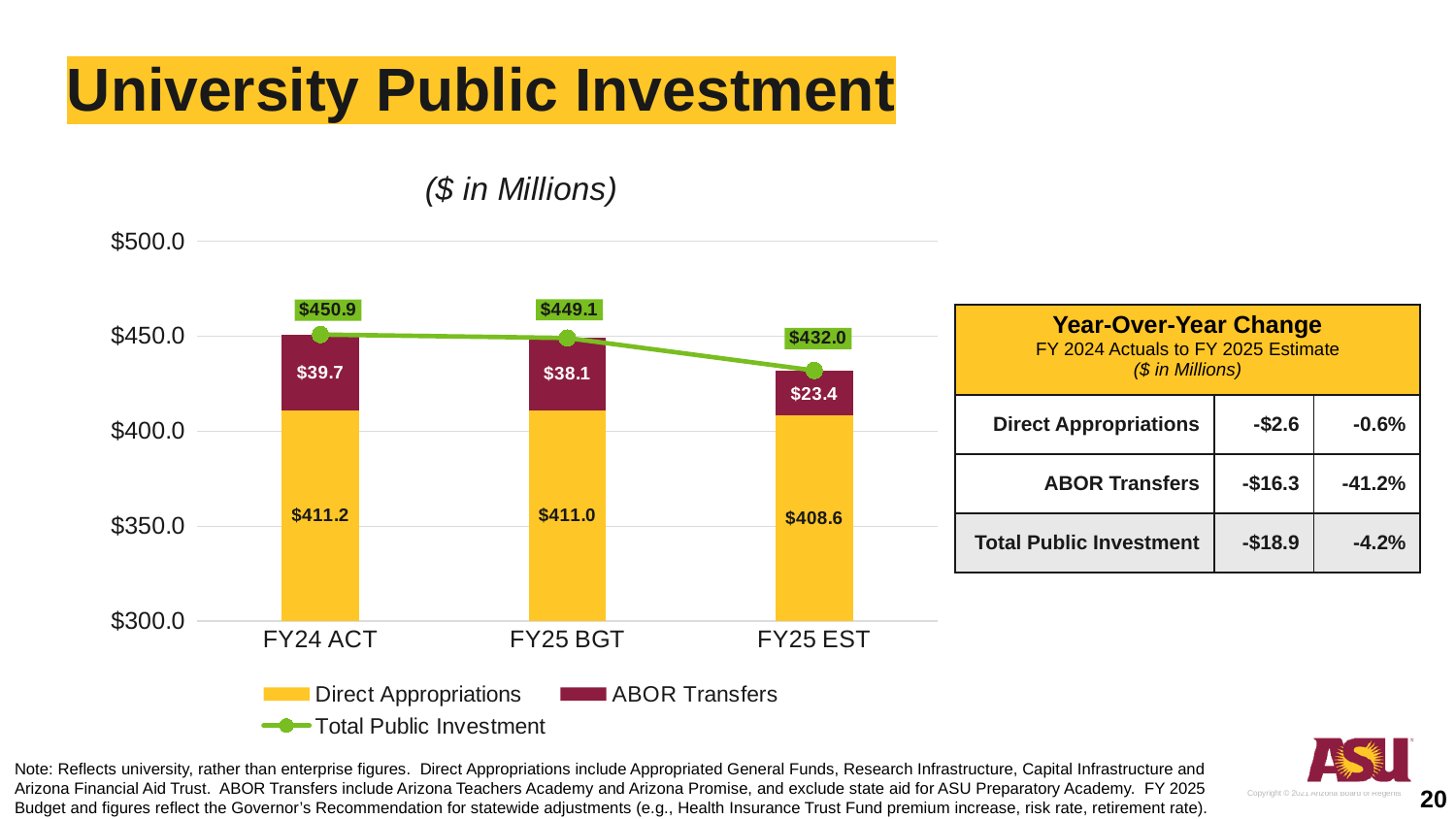
Which is larger, Direct Appropriations for FY24 ACT or for FY25 EST? FY24 ACT How many categories are shown on the x axis? 3 Is the Total Public Investment for FY25 EST greater or less than $450.0? less What is the value of ABOR Transfers for FY25 EST? $23.4 Which category has the highest ABOR Transfers value? FY24 ACT What is the Total Public Investment for FY25 BGT? $449.1 What is the difference between ABOR Transfers for FY24 ACT and FY25 EST? $16.3 What is the total of the stacked bar for FY25 EST? $432.0 What is the value of Direct Appropriations for FY24 ACT? $411.2 Does the Total Public Investment line rise or fall from FY24 ACT to FY25 EST? fall Which category has the lowest Total Public Investment? FY25 EST How many series does the legend list? 3